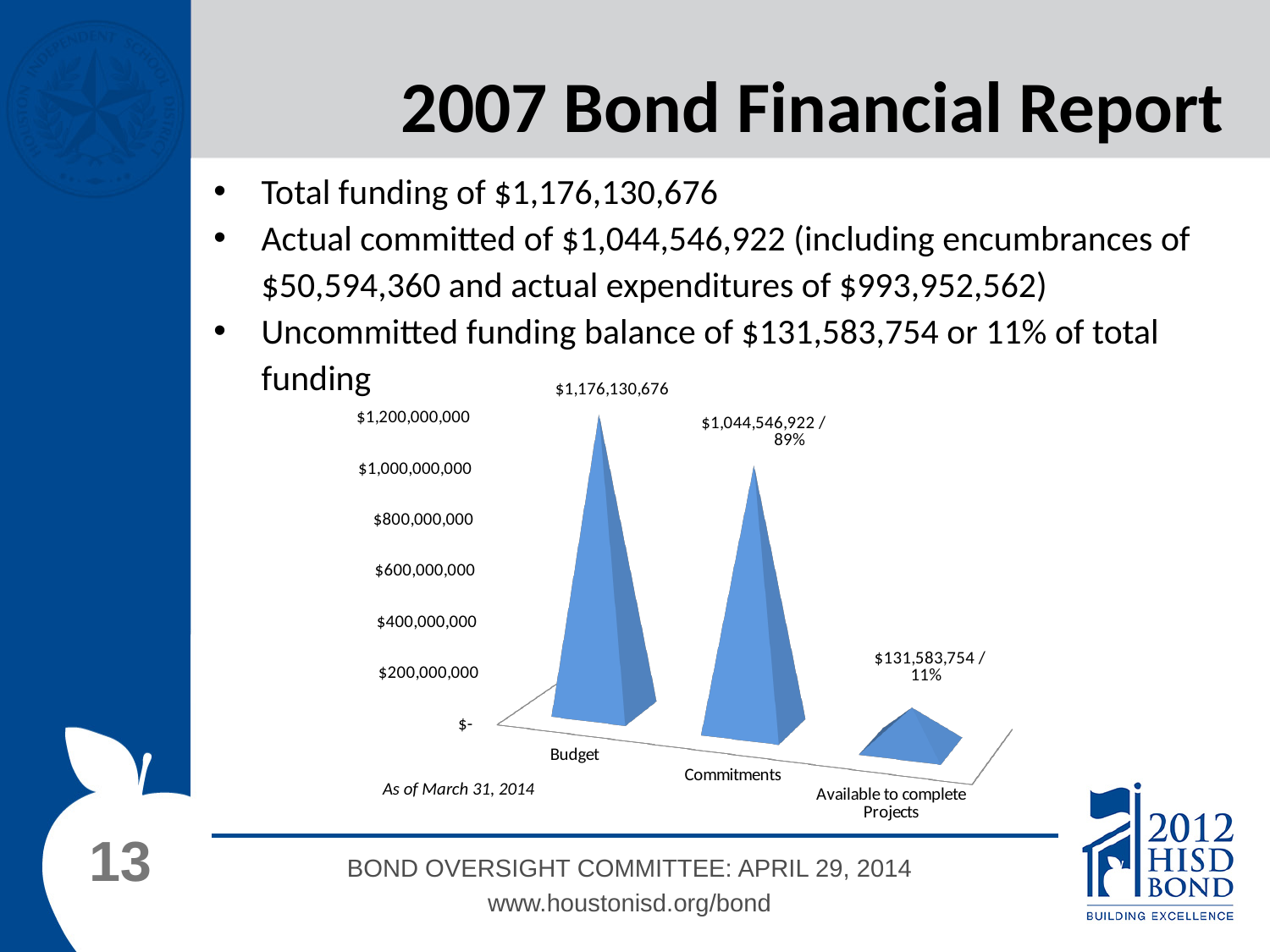
What date note is printed below the chart? As of March 31, 2014 Which category has the highest value in the chart? Budget What is the value for Budget in the chart? $1,176,130,676 What is the value for Available to complete Projects in the chart? $131,583,754 What percentage is shown in the data label for Available to complete Projects? 11% Is the value for Commitments greater or less than $1,000,000,000? greater What percentage is shown in the data label for Commitments? 89% What is the difference between the Budget value and the Commitments value? $131,583,754 What is the value for Commitments in the chart? $1,044,546,922 Which is larger, the value for Commitments or the value for Available to complete Projects? Commitments Which category has the lowest value in the chart? Available to complete Projects How many categories are shown on the x axis of the chart? 3